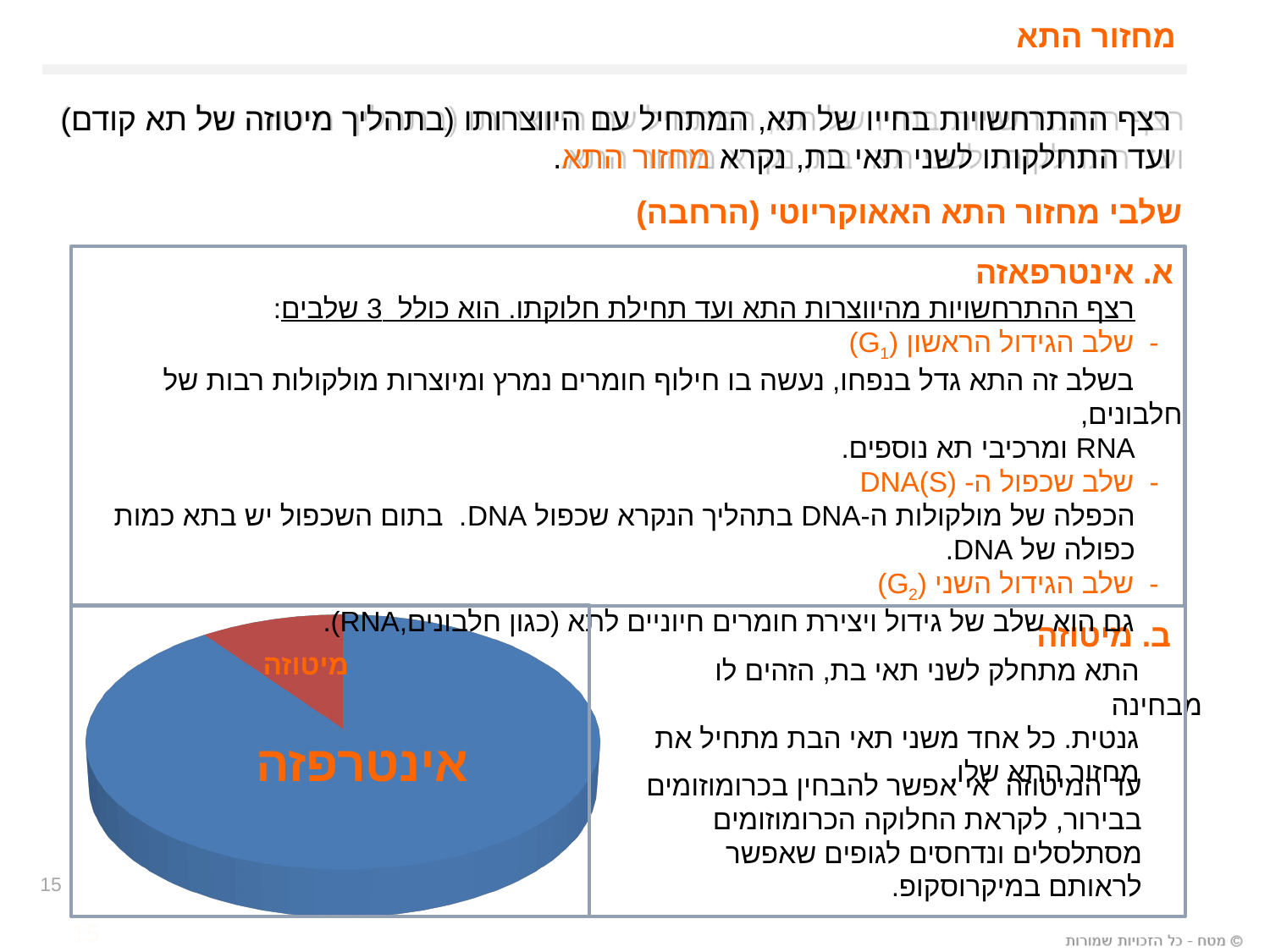
Does the אינטרפזה slice take up more or less than half of the pie chart? more What colour is the מיטוזה slice in the pie chart? red What kind of chart is shown at the bottom left of the slide? pie chart How many slices does the pie chart have? 2 Which slice is larger in the pie chart, אינטרפזה or מיטוזה? אינטרפזה Which slice of the pie chart is the smallest? מיטוזה What colour is the אינטרפזה slice in the pie chart? blue Which slice of the pie chart is the largest? אינטרפזה